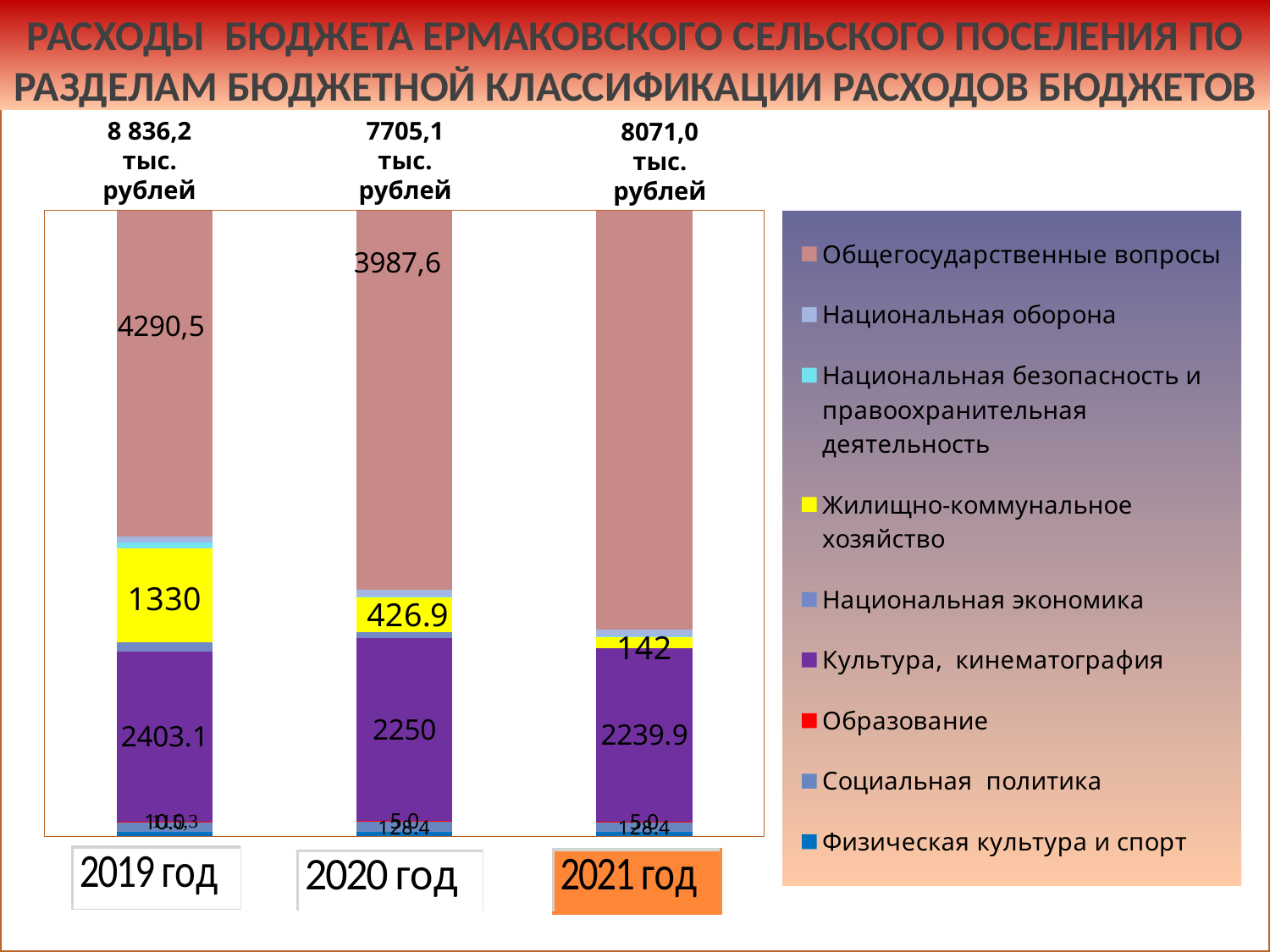
Does the value for Жилищно-коммунальное хозяйство rise or fall from 2019 to 2021? Fall What kind of chart is shown on the slide? Stacked bar chart What is the value for Общегосударственные вопросы in 2019 год? 4290,5 How many years (bars) are shown in the chart? 3 What is the value for Культура, кинематография in 2021 год? 2239.9 How many series does the legend list? 9 Which is larger: Жилищно-коммунальное хозяйство in 2019 год or in 2020 год? 2019 год What is the difference between Общегосударственные вопросы in 2019 год and 2020 год? 302,9 What is the total shown above the 2019 год bar? 8 836,2 тыс. рублей Which year has the highest total expenditure? 2019 год What is the value for Жилищно-коммунальное хозяйство in 2020 год? 426.9 What is the value for Жилищно-коммунальное хозяйство in 2021 год? 142